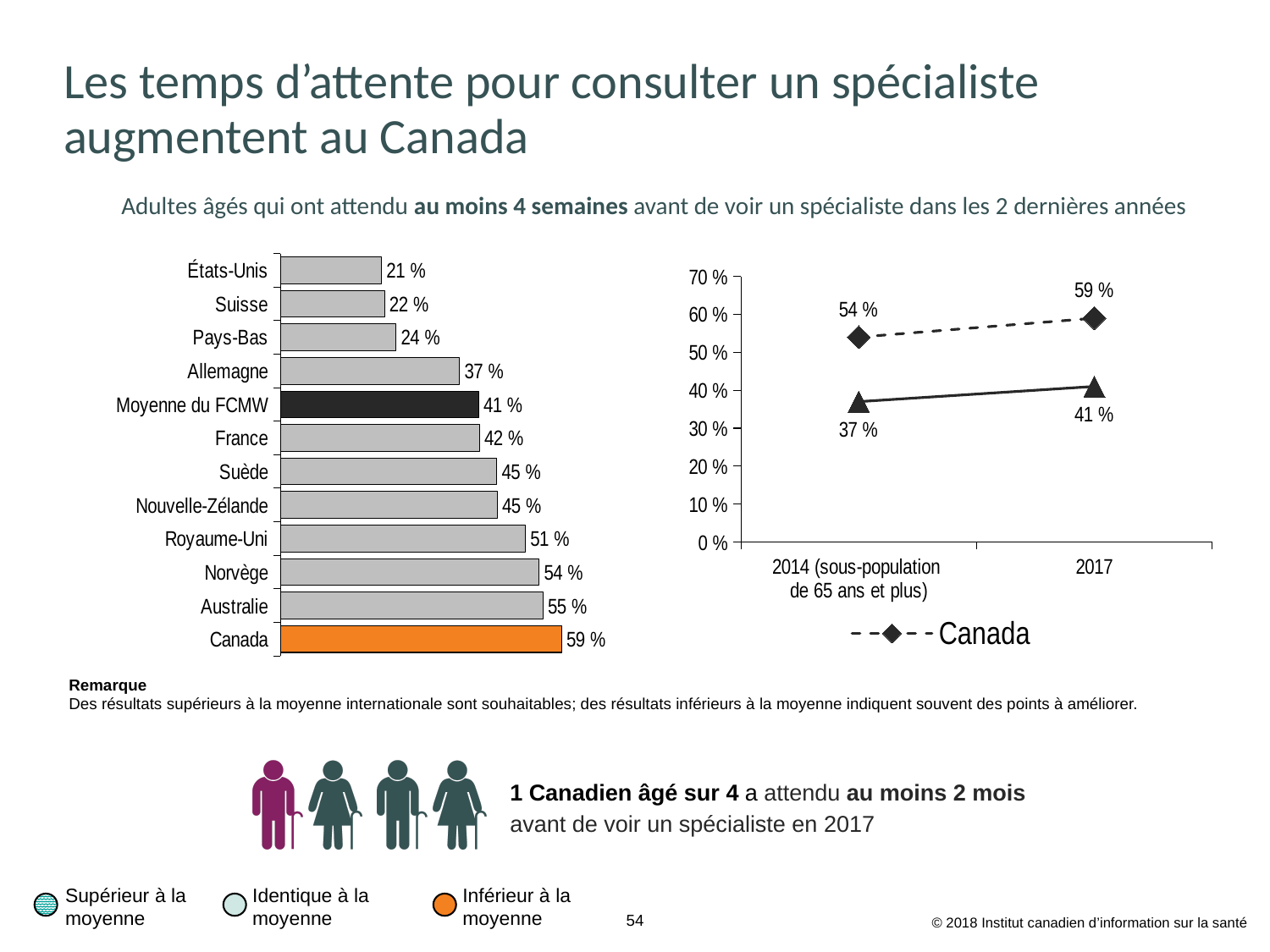
How many series does the legend of the line chart on the right list? 1 What kind of chart is the chart on the left? Bar chart In the line chart on the right, by how much did the value for Canada change between 2014 and 2017? 5 % In the bar chart on the left, which has the larger value, Norvège or Australie? Australie How many categories are shown in the bar chart on the left? 12 In the bar chart on the left, which country has the highest value? Canada In the line chart on the right, what is the value for Canada in 2017? 59 % In the bar chart on the left, what is the difference between the value for Canada and the Moyenne du FCMW? 18 % In the bar chart on the left, what is the value for Allemagne? 37 % In the bar chart on the left, what is the value for Canada? 59 % In the line chart on the right, does the value for Canada rise or fall from 2014 to 2017? Rise In the bar chart on the left, which country has the lowest value? États-Unis